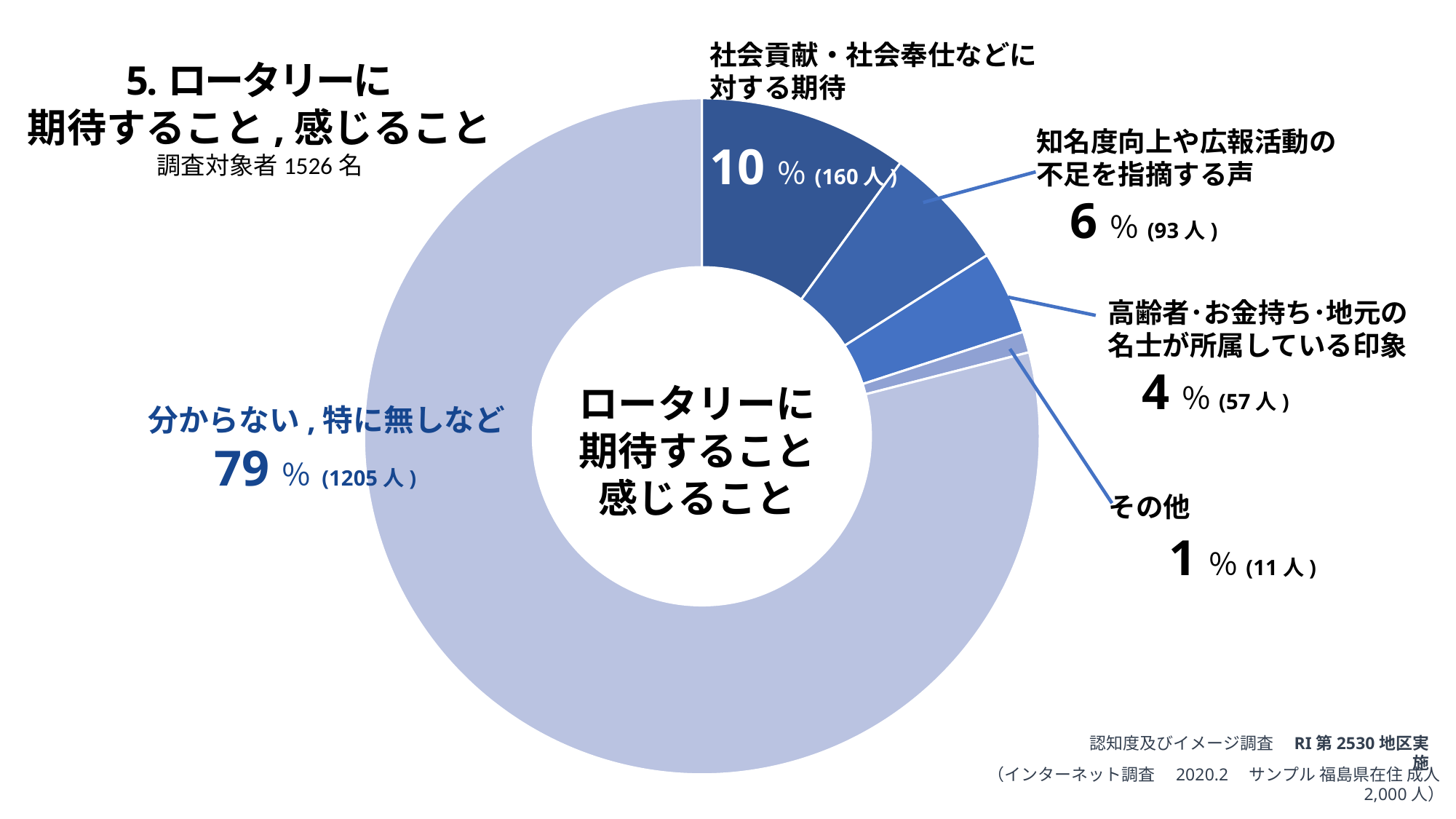
How many more people chose 社会貢献・社会奉仕などに対する期待 than 知名度向上や広報活動の不足を指摘する声? 67人 How many categories does the donut chart show? 5 What text is written in the centre of the donut chart? ロータリーに期待すること感じること What kind of chart is shown on the slide? Donut (pie) chart How many people (人) are shown for その他? 11人 What percentage is shown for 社会貢献・社会奉仕などに対する期待? 10% How many people (人) are shown for 知名度向上や広報活動の不足を指摘する声? 93人 Which is larger: the share for 知名度向上や広報活動の不足を指摘する声 or for 高齢者・お金持ち・地元の名士が所属している印象? 知名度向上や広報活動の不足を指摘する声 What percentage is shown for 高齢者・お金持ち・地元の名士が所属している印象? 4% Which category has the largest share of the donut chart? 分からない, 特に無しなど Which category has the smallest share of the donut chart? その他 What is the difference in percentage points between 分からない, 特に無しなど and 社会貢献・社会奉仕などに対する期待? 69 percentage points